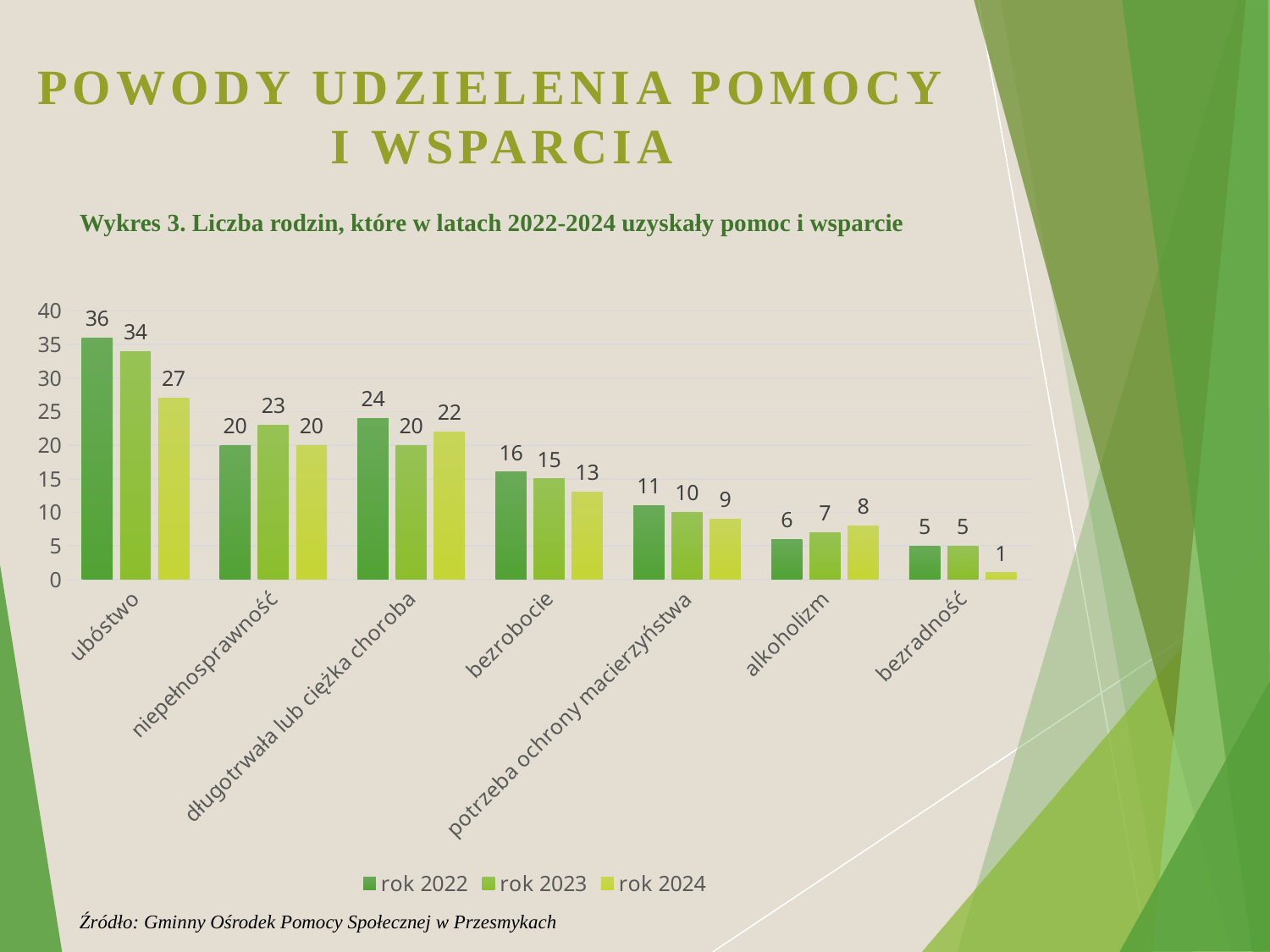
Which category has the highest value in rok 2022? ubóstwo How many categories are shown on the x axis? 7 What is the value for alkoholizm in rok 2023? 7 Do the rok 2022 values rise or fall from ubóstwo to bezradność along the x axis? fall How many series does the legend list? 3 What is the value for bezrobocie in rok 2024? 13 Which category has the lowest value in rok 2024? bezradność What is the difference between the rok 2022 and rok 2024 values for ubóstwo? 9 What is the title of the chart? Wykres 3. Liczba rodzin, które w latach 2022-2024 uzyskały pomoc i wsparcie Which is larger for długotrwała lub ciężka choroba: the rok 2022 value or the rok 2024 value? rok 2022 What kind of chart is shown on the slide? bar chart What is the value for ubóstwo in rok 2022? 36